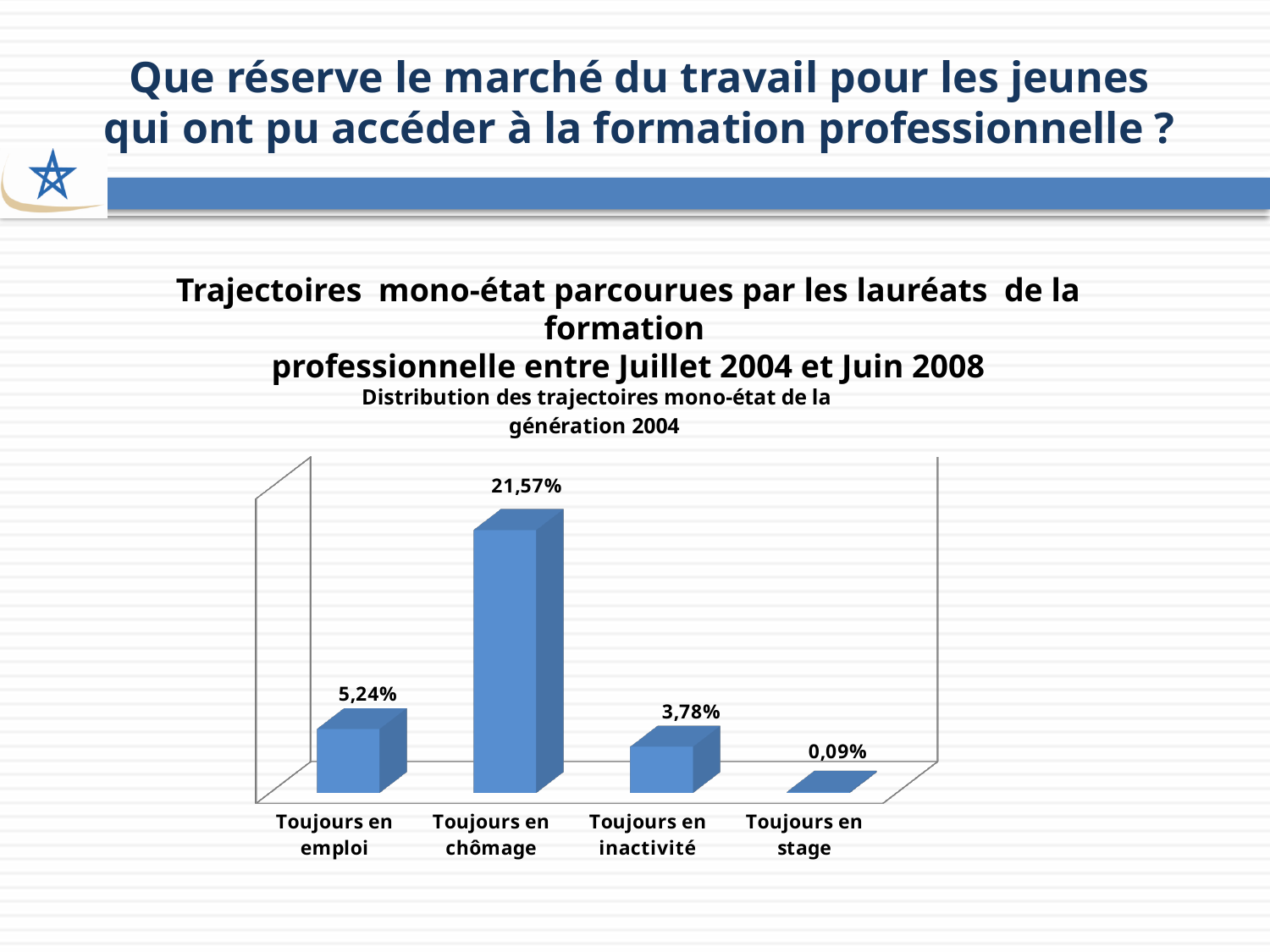
What is the title of the chart? Distribution des trajectoires mono-état de la génération 2004 What is the value for "Toujours en chômage"? 21,57% What is the difference between the values for "Toujours en emploi" and "Toujours en inactivité"? 1,46% How many categories are shown in the chart? 4 What is the value for "Toujours en stage"? 0,09% What kind of chart is shown on the slide? Bar chart Which is larger, the value for "Toujours en emploi" or the value for "Toujours en inactivité"? Toujours en emploi What is the difference between the values for "Toujours en chômage" and "Toujours en emploi"? 16,33% What is the value for "Toujours en emploi"? 5,24% What is the value for "Toujours en inactivité"? 3,78% Which category has the highest value? Toujours en chômage Which category has the lowest value? Toujours en stage